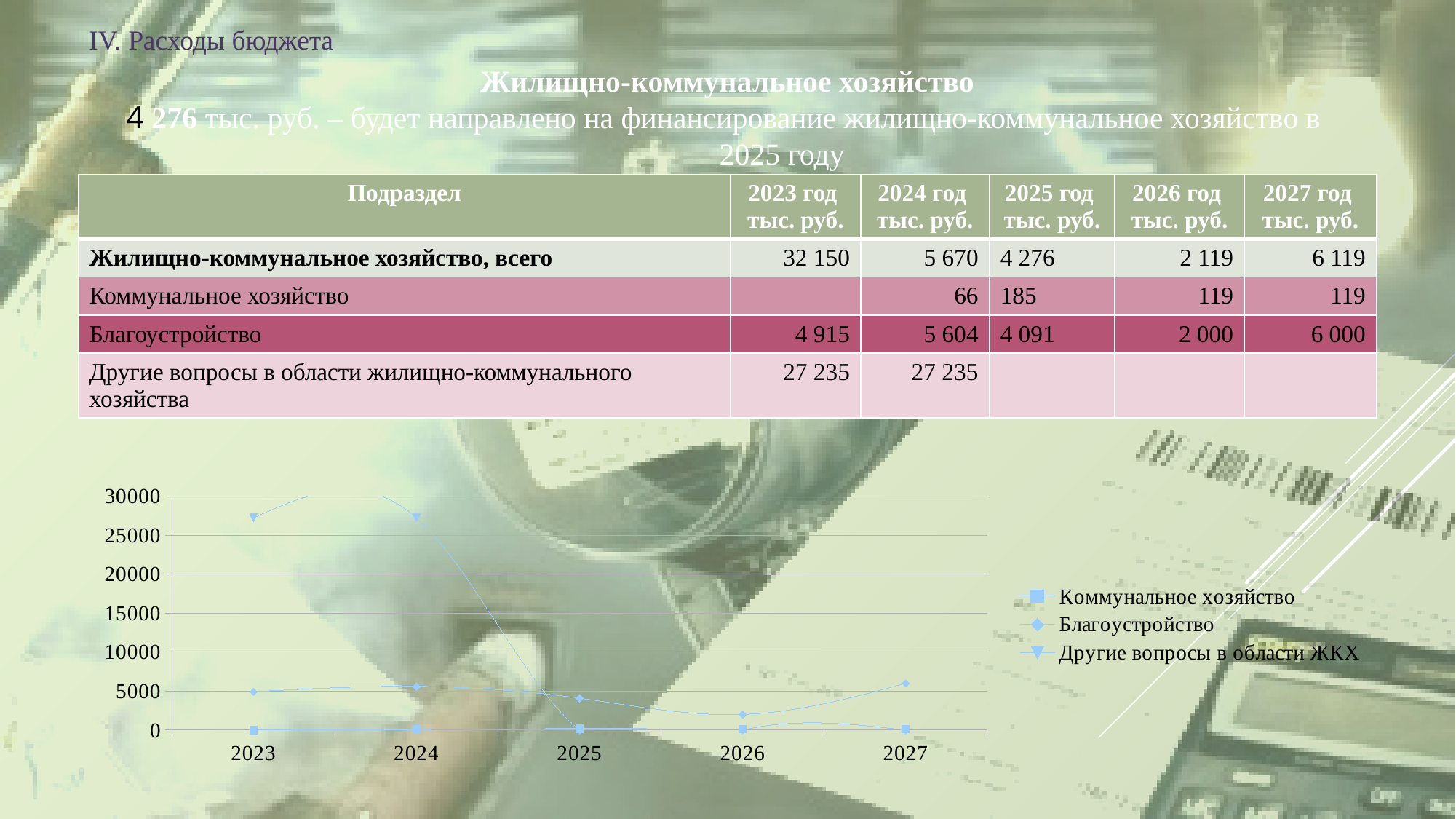
According to the table on the slide, what is the value for Благоустройство in 2025 (тыс. руб.)? 4 091 Does the Другие вопросы в области ЖКХ line rise or fall from 2024 to 2025? fall Is the value for Благоустройство in 2023 greater or less than 10000? less Does the Благоустройство line rise or fall from 2024 to 2026? fall In which year is the Благоустройство line at its highest? 2027 How many series does the chart legend list? 3 How many years are shown along the x axis of the chart? 5 Which series is listed first in the chart legend? Коммунальное хозяйство In 2025, which is larger: Благоустройство or Коммунальное хозяйство? Благоустройство What kind of chart is shown on the slide? line chart Is the value for Другие вопросы в области ЖКХ in 2023 greater or less than 25000? greater In which year is the Благоустройство line at its lowest? 2026